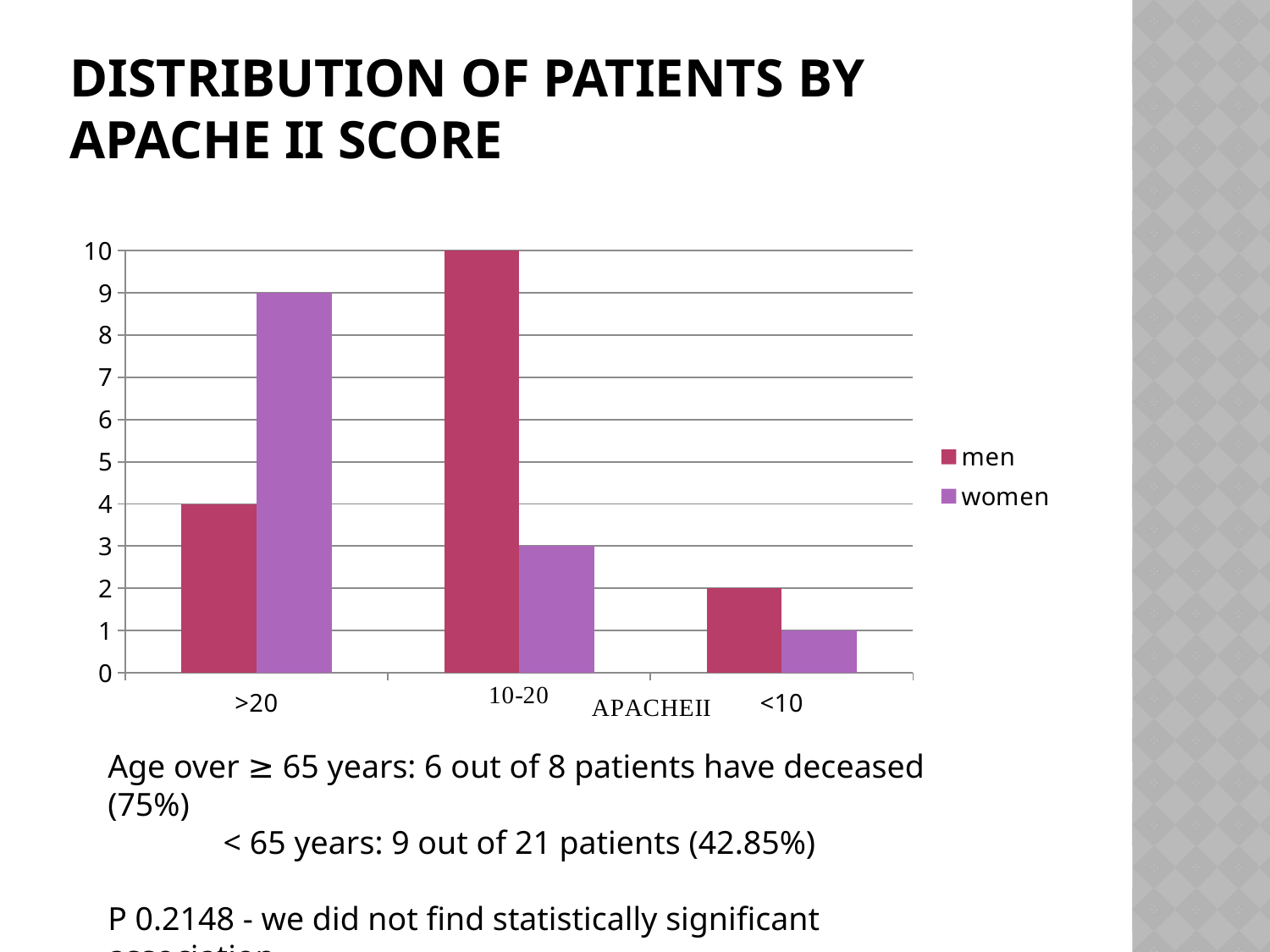
In the >20 category, which is larger, men or women? women In which category is the value for men highest? 10-20 Which series is shown in purple in the legend? women What is the difference between men and women in the 10-20 category? 7 What is the value for women in the >20 category? 9 How many series does the legend list? 2 What type of chart is shown on the slide? bar chart What is the value for men in the >20 category? 4 What is the value for men in the 10-20 category? 10 How many APACHE II score categories are shown on the x axis? 3 In which category is the value for women lowest? <10 What is the value for women in the <10 category? 1